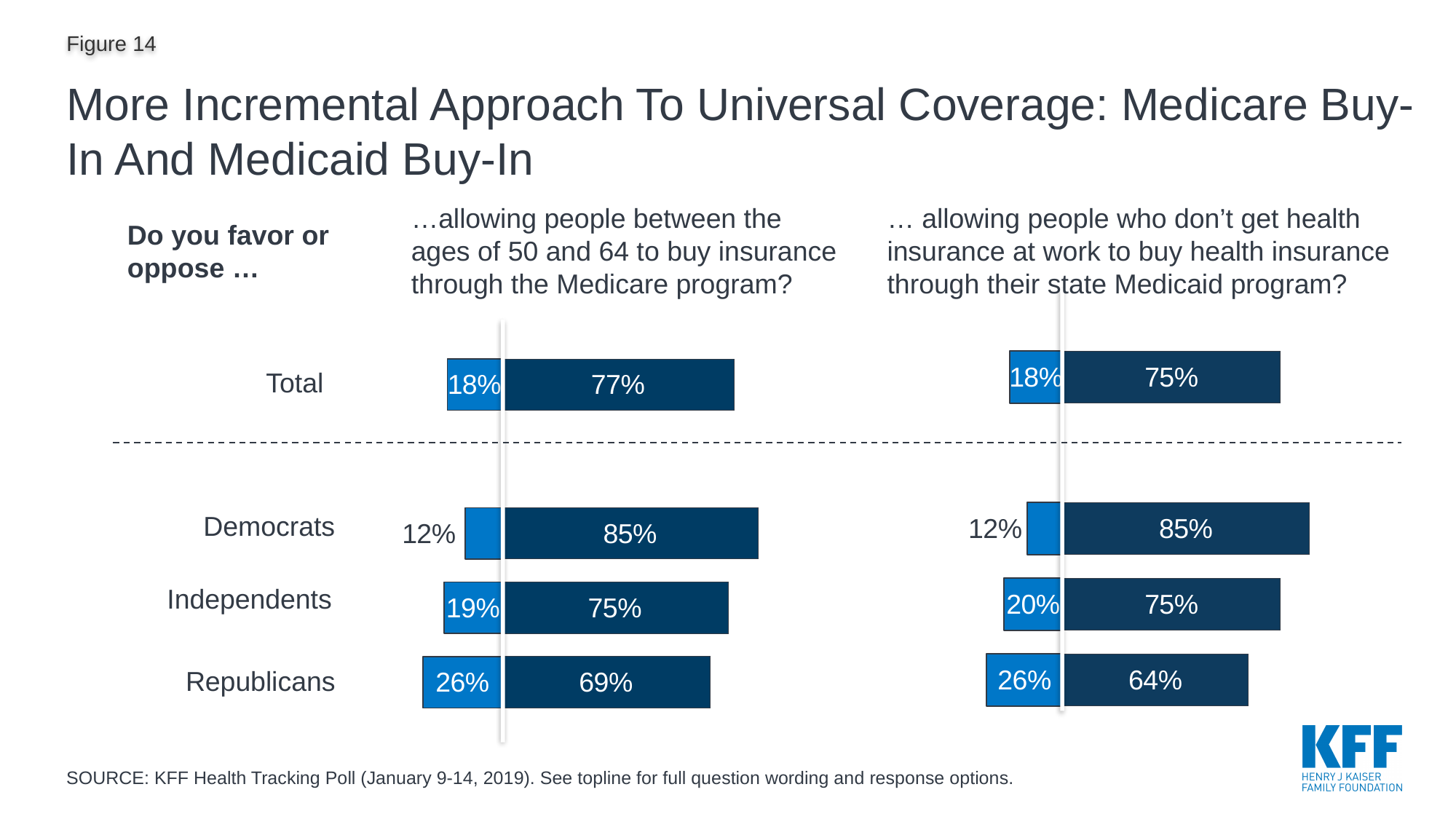
In the left chart (Medicare buy-in), what is the difference between the share of Democrats and the share of Republicans who favor the proposal? 16 percentage points In the left chart (Medicare buy-in), what percentage of Independents oppose the proposal? 19% How many groups are shown in each chart? 4 What is the source cited for the data on this slide? KFF Health Tracking Poll (January 9-14, 2019) In the left chart (Medicare buy-in), which group has the highest share in favor? Democrats What type of chart is used on this slide? Bar chart In the left chart (Medicare buy-in for ages 50 to 64), what percentage of the Total favor the proposal? 77% In the right chart (Medicaid buy-in), which group has the lowest share in favor? Republicans In the right chart (Medicaid buy-in), what percentage of Independents oppose the proposal? 20% In the right chart (Medicaid buy-in), what percentage of Republicans favor the proposal? 64% Is the share of Republicans who favor the proposal larger in the left chart (Medicare buy-in) or the right chart (Medicaid buy-in)? Left chart (Medicare buy-in) In the right chart (Medicaid buy-in), what is the difference between the share of Republicans who oppose and the share of Democrats who oppose? 14 percentage points